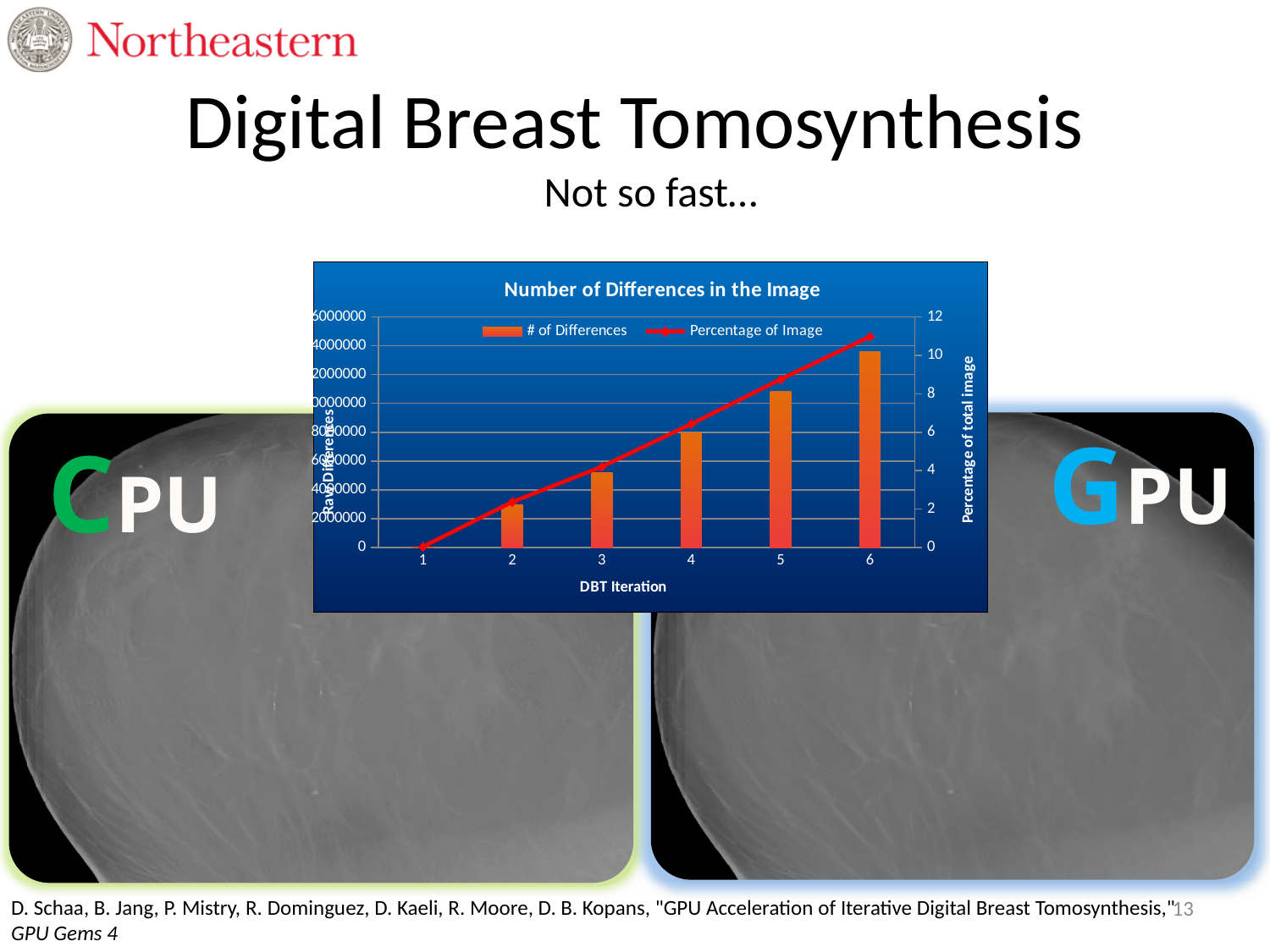
Which has a larger # of Differences, DBT iteration 3 or DBT iteration 5? DBT iteration 5 Is the # of Differences at DBT iteration 6 greater or less than 12000000? greater What are the two series named in the legend? # of Differences and Percentage of Image Do the values of the Percentage of Image line rise or fall as the DBT iteration increases? Rise Is the Percentage of Image at DBT iteration 6 greater or less than 10? greater What is the title of the chart? Number of Differences in the Image Which DBT iteration has the highest # of Differences? 6 What kind of chart is shown on the slide? A combined bar and line chart Which DBT iteration has the lowest Percentage of Image? 1 Is the Percentage of Image at DBT iteration 2 greater or less than 4? less How many series does the chart legend list? 2 How many DBT iterations are plotted along the x axis? 6